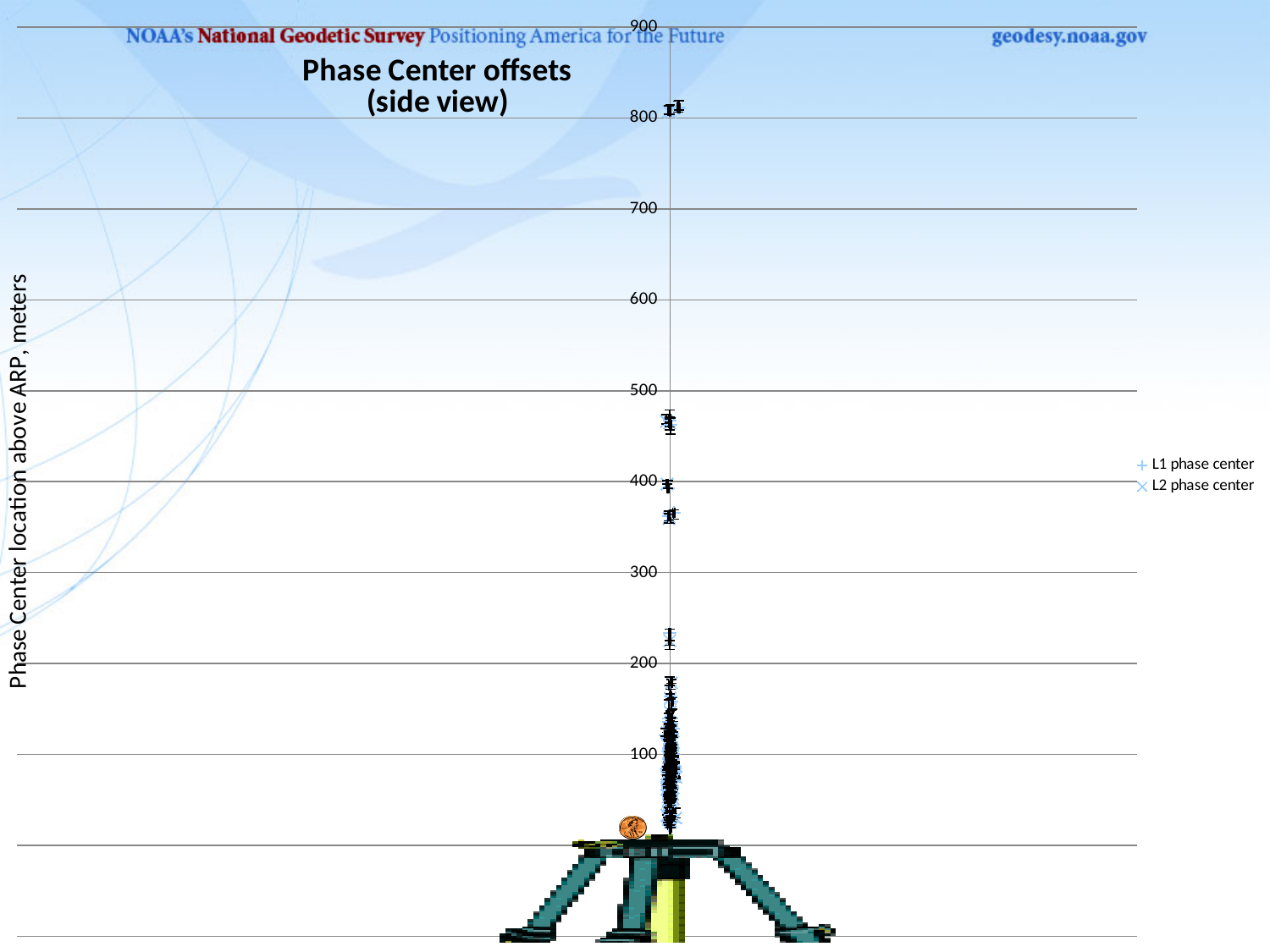
Are the lowest plotted phase center points greater or less than 100 on the vertical axis? less What kind of chart is shown on the slide? scatter chart What is the title of the chart? Phase Center offsets (side view) What is the label on the vertical axis of the chart? Phase Center location above ARP, meters How many series does the chart legend list? 2 Is the isolated cluster of points between the 200 and 300 gridlines greater or less than 300? less Which marker symbol represents the L2 phase center series in the legend? an x (cross) marker Is the highest plotted phase center point greater or less than 900 on the vertical axis? less What is the highest tick value shown on the vertical axis? 900 What are the two series named in the chart legend? L1 phase center and L2 phase center